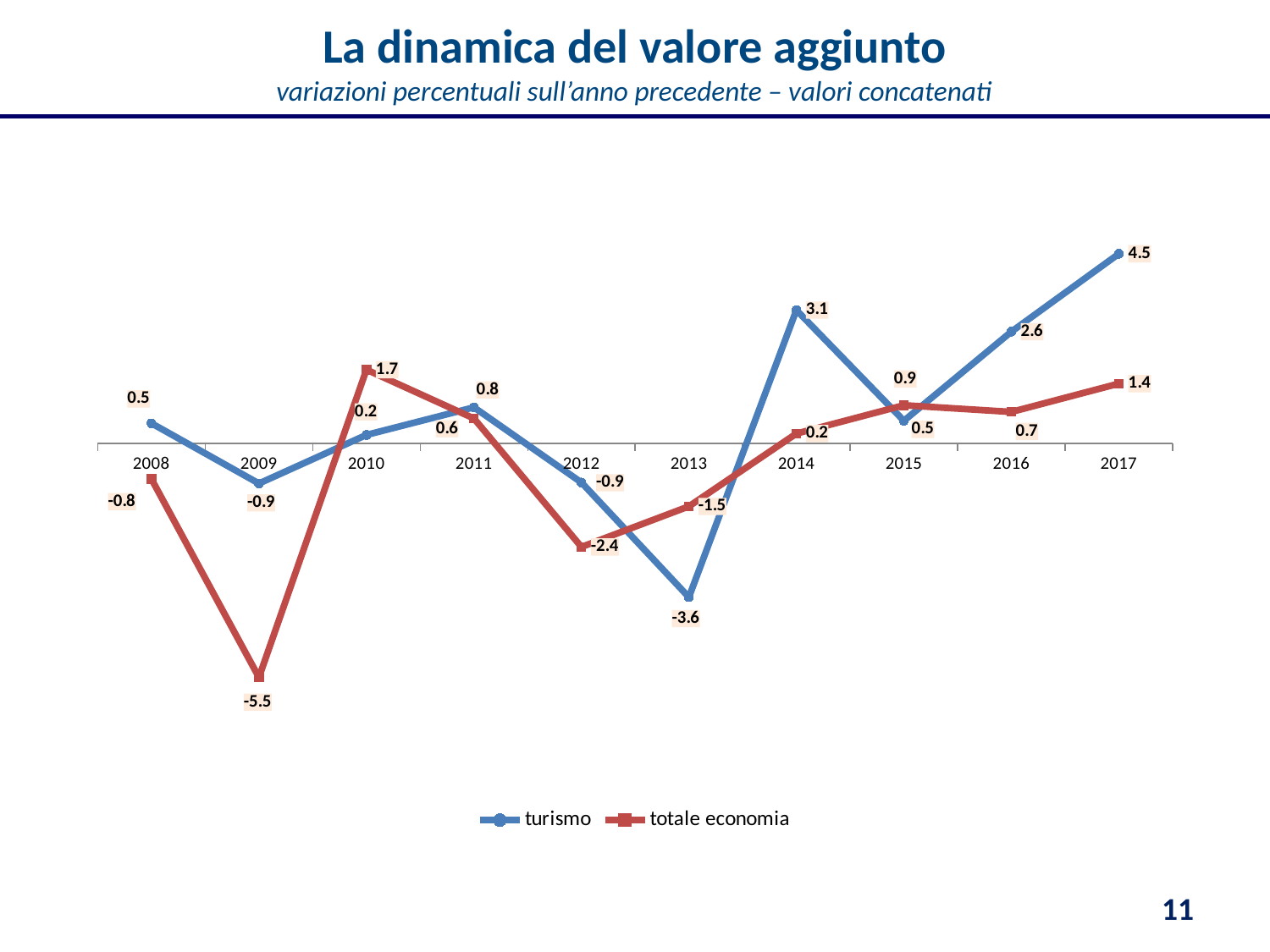
How many series does the legend list? 2 What is the value for turismo in 2017? 4.5 What is the difference between turismo and totale economia in 2014? 2.9 What is the value for turismo in 2013? -3.6 Does the turismo series rise or fall from 2015 to 2017? rise What kind of chart is shown on the slide? line chart In which year does turismo reach its highest value? 2017 How many years are shown on the x axis? 10 In which year does totale economia reach its lowest value? 2009 Which series has the higher value in 2015, turismo or totale economia? totale economia What is the value for totale economia in 2014? 0.2 What is the value for totale economia in 2009? -5.5